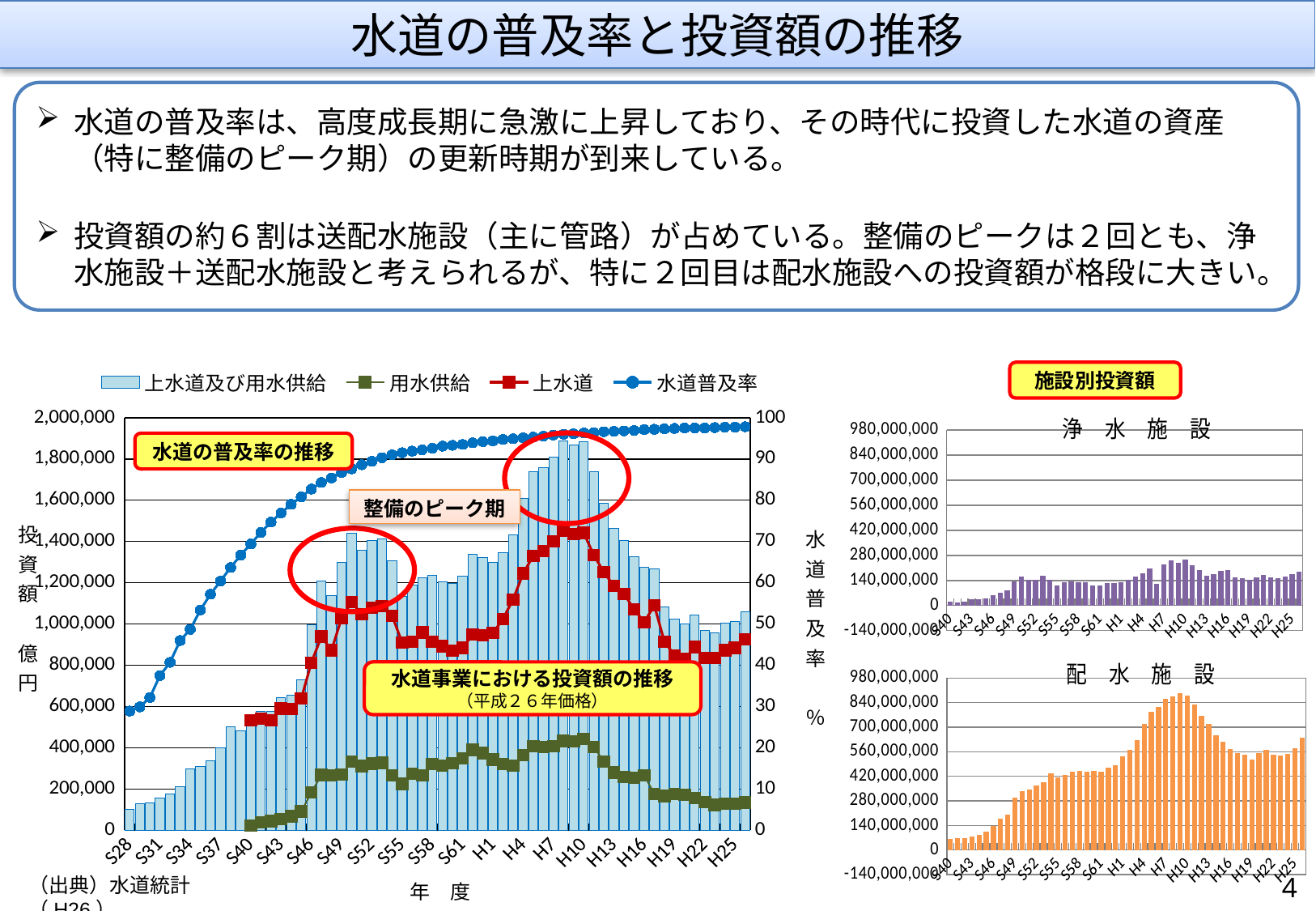
In the 配水施設 chart, is the tallest bar greater or less than 700,000,000? greater Which chart on the right reaches a higher peak value, 浄水施設 or 配水施設? 配水施設 What is the x-axis label of the left chart? 年度 In the left chart, is the 上水道及び用水供給 bar at S28 greater or less than 200,000? less In the left chart, does the 水道普及率 line rise or fall along the x axis from S28 to H25? rise In the left chart, is the tallest 上水道及び用水供給 bar (around H10) greater or less than 1,600,000? greater What kind of chart is the 配水施設 chart on the right? bar chart What is the heading above the two charts on the right side of the slide? 施設別投資額 In the left chart, how many series does the legend list? 4